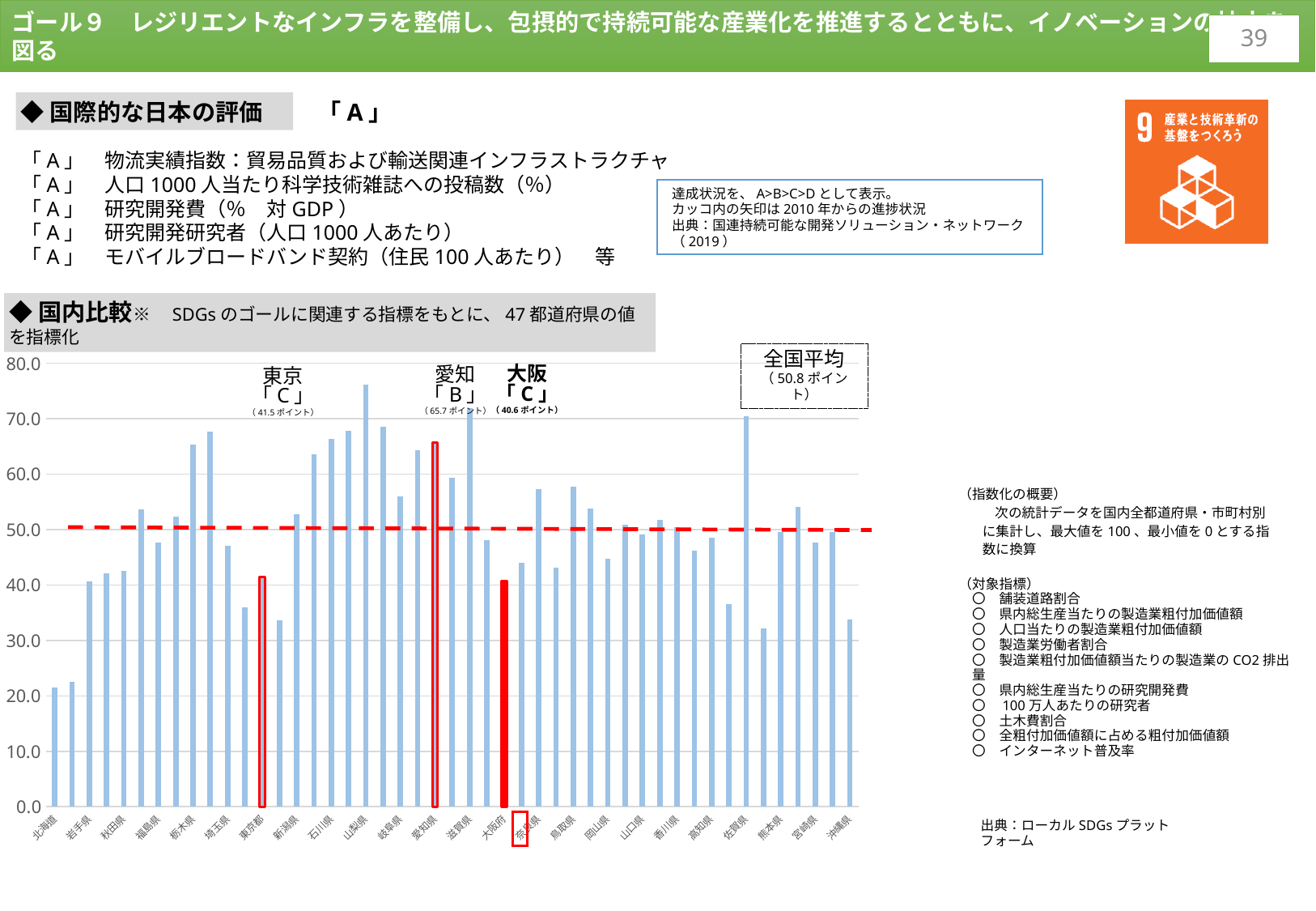
On the 国内比較 bar chart, is the value for 佐賀県 greater or less than 60.0? greater On the 国内比較 bar chart, what does the red dashed horizontal line represent? 全国平均 (50.8 ポイント) On the 国内比較 bar chart, is the value for 北海道 greater or less than 30.0? less What value is printed for 東京 on the 国内比較 bar chart? 41.5 ポイント What kind of chart is used for the 国内比較 section? bar chart On the 国内比較 bar chart, which prefecture has the highest bar? 山梨県 What value is printed for 愛知 on the 国内比較 bar chart? 65.7 ポイント On the 国内比較 bar chart, which has the larger printed value, 東京 or 大阪? 東京 What is the 全国平均 value shown on the 国内比較 bar chart? 50.8 ポイント On the 国内比較 bar chart, is the value for 沖縄県 greater or less than 40.0? less What value is printed for 大阪 on the 国内比較 bar chart? 40.6 ポイント On the 国内比較 bar chart, what is the difference between the printed values for 愛知 and 東京? 24.2 ポイント